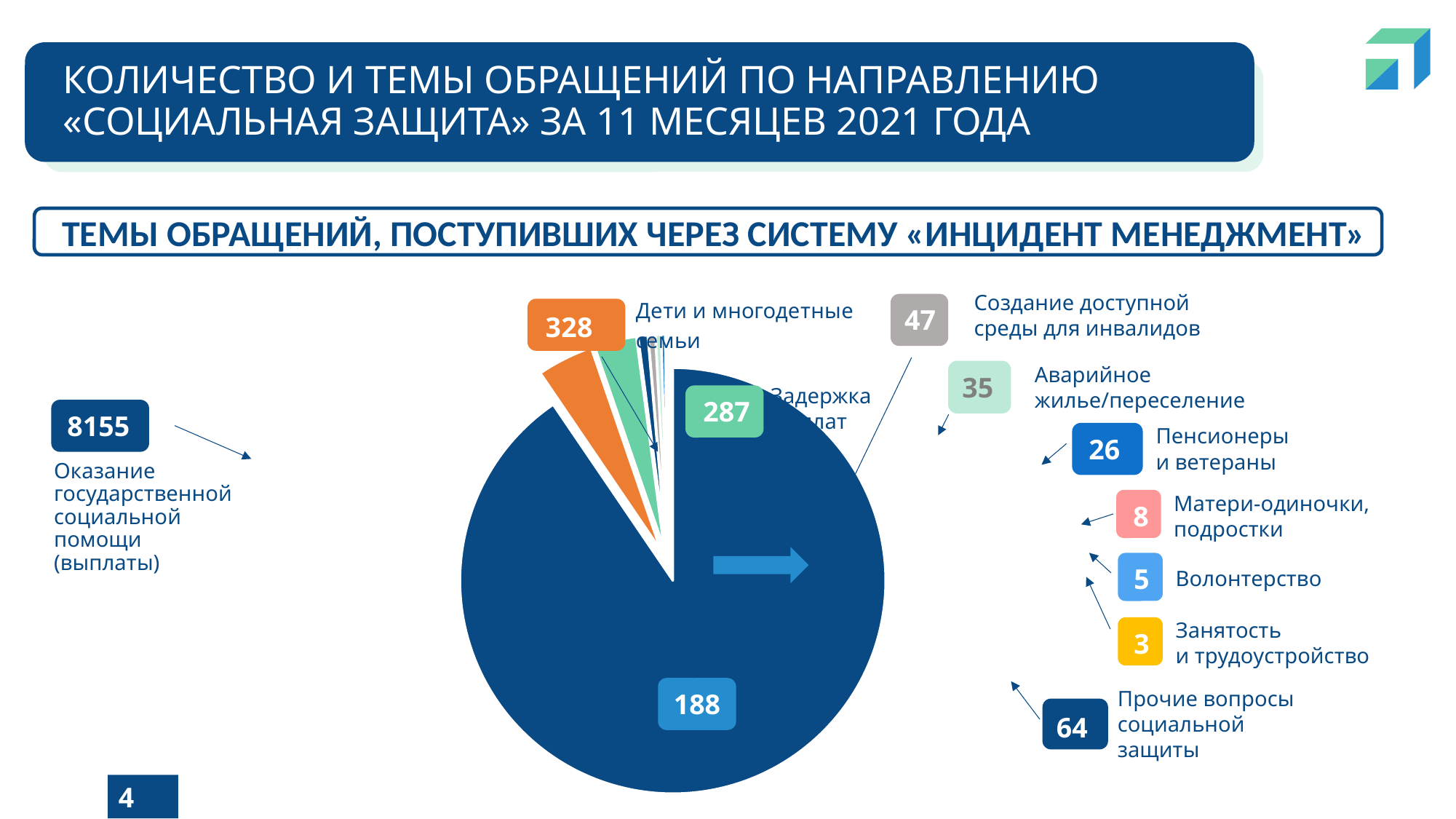
What is the value for «Прочие вопросы социальной защиты»? 64 Which category has the highest value? Оказание государственной социальной помощи (выплаты) What is the difference between the values for «Дети и многодетные семьи» and «Создание доступной среды для инвалидов»? 281 What is the value for «Дети и многодетные семьи»? 328 What is the difference between the values for «Прочие вопросы социальной защиты» and «Аварийное жилье/переселение»? 29 Which is larger: the value for «Пенсионеры и ветераны» or for «Матери-одиночки, подростки»? Пенсионеры и ветераны What is the value for «Волонтерство»? 5 What is the value for «Пенсионеры и ветераны»? 26 What kind of chart is shown on the slide? Pie chart What is the value for «Создание доступной среды для инвалидов»? 47 Which category has the lowest value? Занятость и трудоустройство What is the value for «Аварийное жилье/переселение»? 35